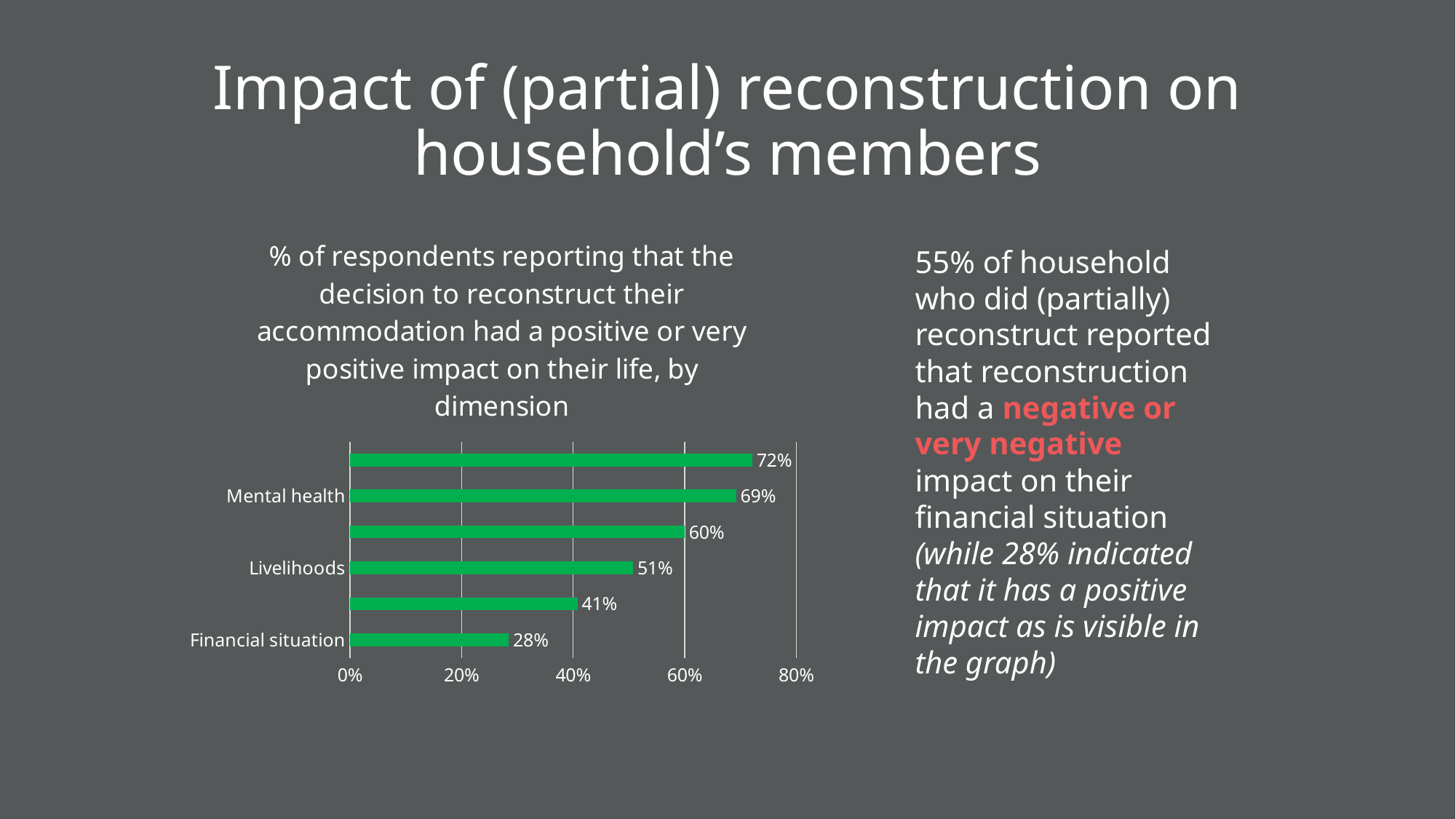
What is the value shown for Livelihoods? 51% Which is larger, the value for Mental health or the value for Livelihoods? Mental health What colour are the bars in the chart? Green Which labelled category has the lowest value in the chart? Financial situation What is the difference between the values for Livelihoods and Financial situation? 23% What is the difference between the values for Mental health and Livelihoods? 18% What is the largest value printed on any bar in the chart? 72% How many bars are plotted in the chart? 6 What kind of chart is shown on the slide? Bar chart Is the value for Financial situation greater or less than 40%? less What is the value shown for Financial situation? 28% What percentage of respondents reported a positive or very positive impact on their mental health? 69%